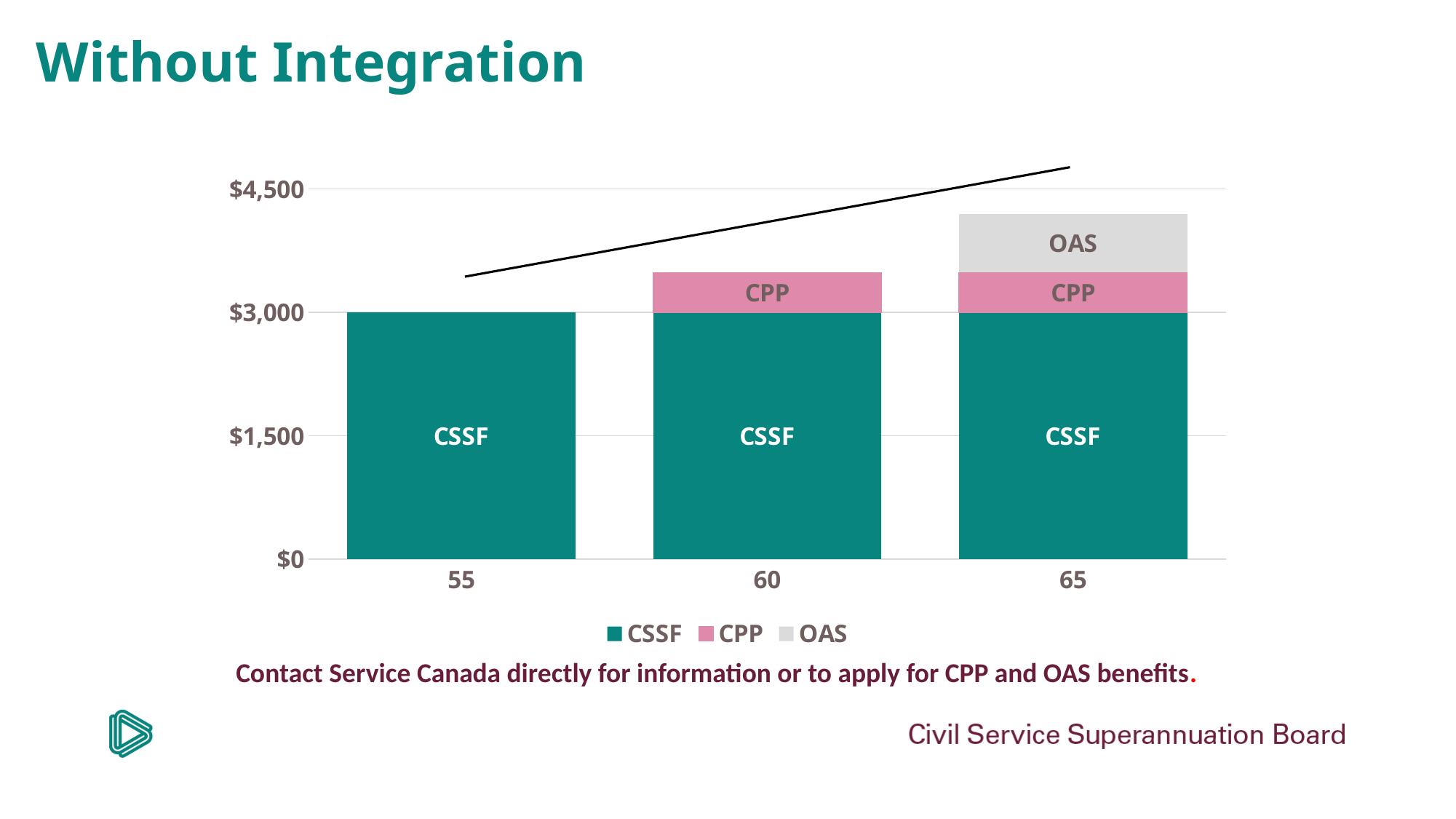
Which age has the highest total stacked bar? 65 What is the CSSF value at age 65? $3,000 Which series appears only in the bar for age 65? OAS How many series does the legend list? 3 Which age has the lowest total stacked bar? 55 Which has the larger total bar, age 55 or age 60? 60 What is the CSSF value at age 55? $3,000 Is the total of the stacked bar for age 60 greater or less than $3,000? greater Is the total of the stacked bar for age 65 greater or less than $4,500? less How many age categories are shown on the x axis? 3 Do the total bar heights rise or fall from age 55 to age 65? rise What kind of chart is shown on the slide? Stacked bar chart